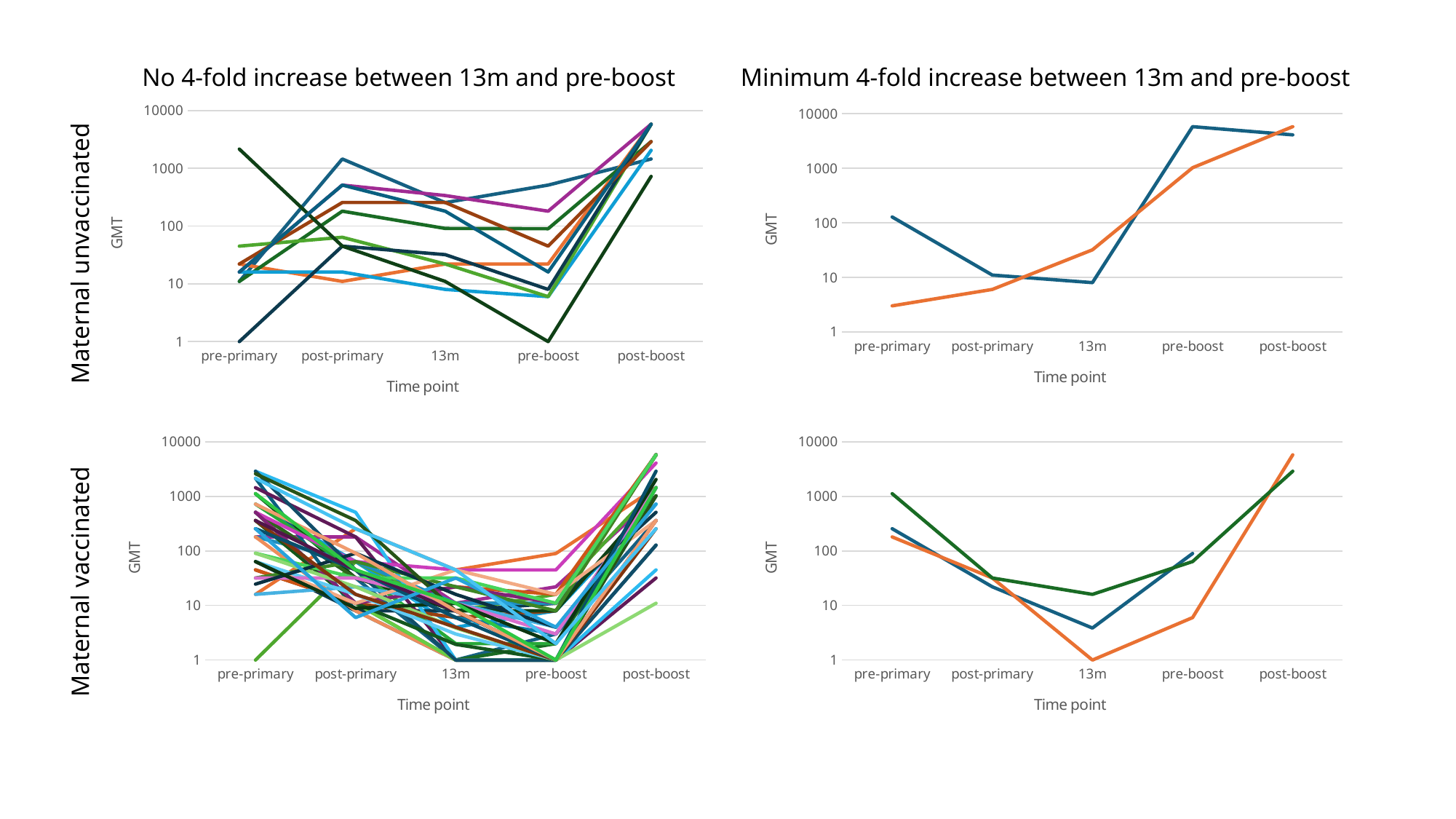
In the bottom-right chart (Maternal vaccinated, Minimum 4-fold increase), is the orange line's value at 13m greater or less than 10? less What is the y-axis title on the charts? GMT How many time points are shown on the x axis of each chart? 5 In the top-right chart (Maternal unvaccinated, Minimum 4-fold increase), is the blue line's value at pre-boost greater or less than 1000? greater In the bottom-right chart (Maternal vaccinated, Minimum 4-fold increase), how many lines are plotted? 3 In the top-right chart (Maternal unvaccinated, Minimum 4-fold increase), is the orange line's value at pre-boost greater or less than 100? greater What kind of chart is used in each of the four panels on the slide? Line chart In the top-right chart (Maternal unvaccinated, Minimum 4-fold increase), which line is higher at pre-primary, the blue or the orange? Blue In the top-right chart (Maternal unvaccinated, Minimum 4-fold increase), how many lines are plotted? 2 In the bottom-right chart (Maternal vaccinated, Minimum 4-fold increase), which line is higher at 13m, the green or the orange? Green In the top-right chart (Maternal unvaccinated, Minimum 4-fold increase), does the orange line rise or fall from pre-primary to post-boost? Rises